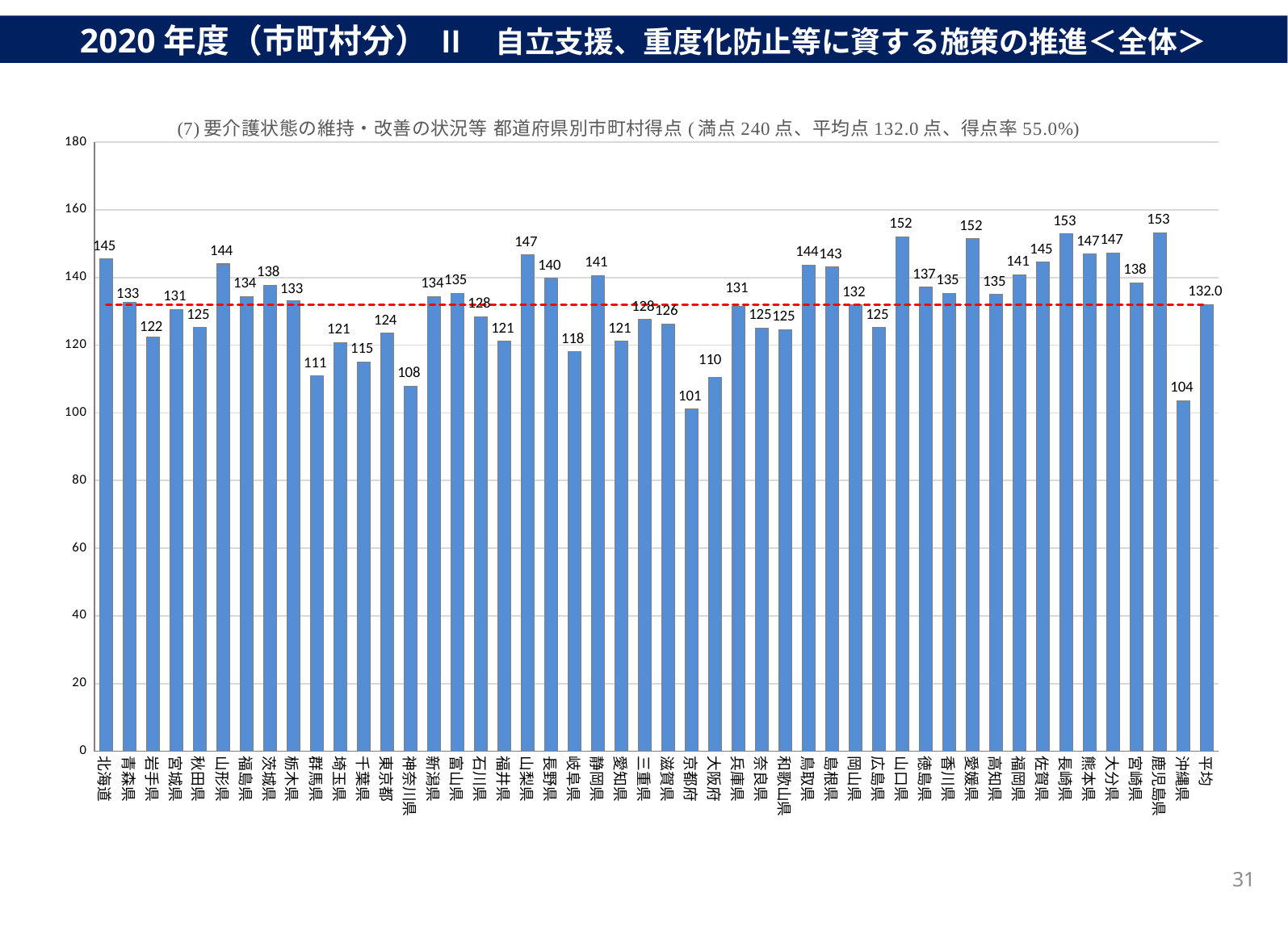
Which prefecture has the lowest value? 京都府 Is the value for 長崎県 greater or less than 140? greater What kind of chart is shown on the slide? bar chart What is the value for 沖縄県? 104 What is the difference between the values for 北海道 and 沖縄県? 41 Which is larger, the value for 東京都 or the value for 大阪府? 東京都 What is the difference between the values for 鹿児島県 and 京都府? 52 What is the value for 山口県? 152 What is the value shown for 平均? 132.0 What is the value for 北海道? 145 What value does the red dashed horizontal line mark? 132.0 Is the value for 群馬県 greater or less than 120? less